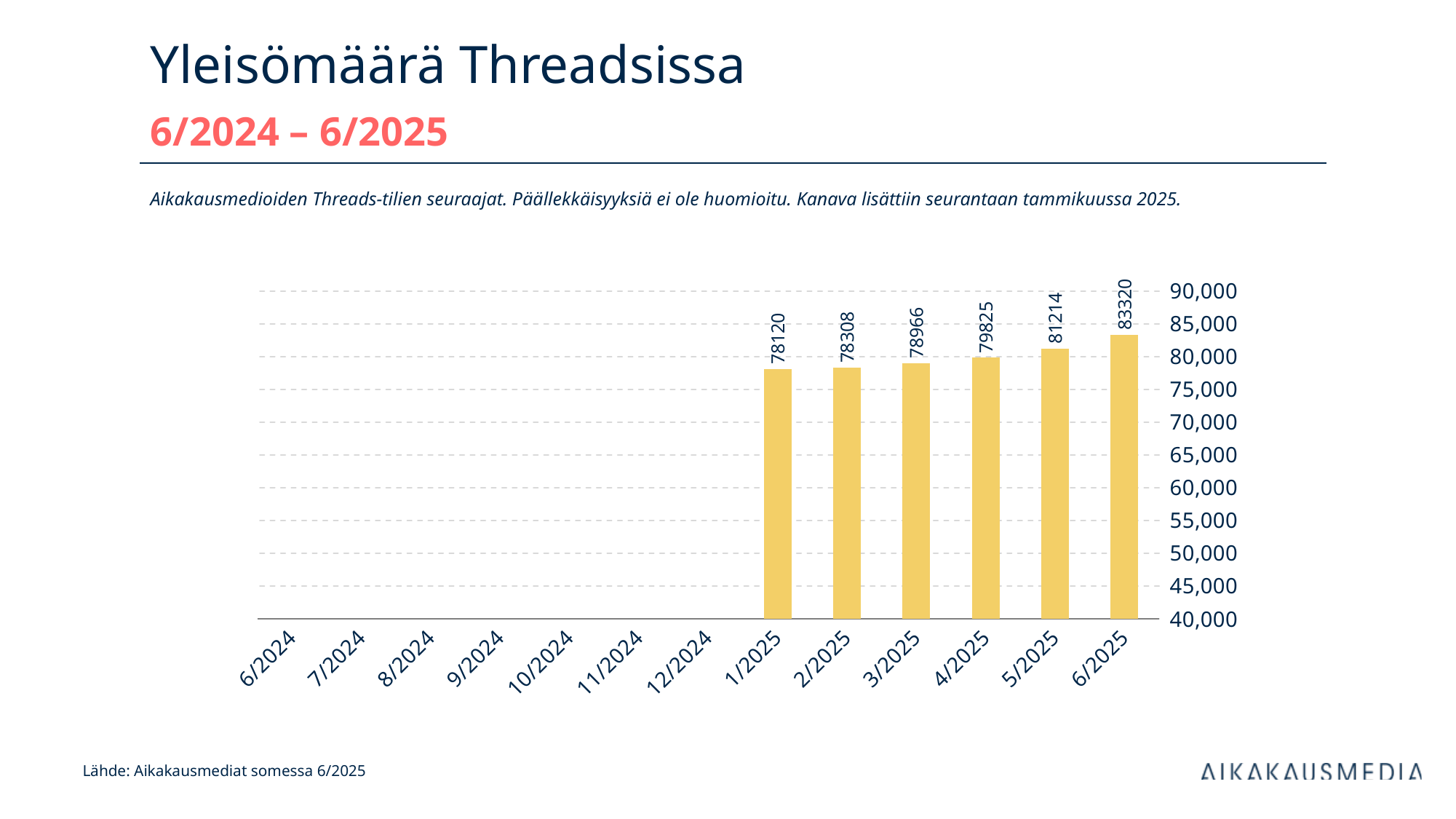
What kind of chart is shown on the slide? bar chart Which month has the highest value? 6/2025 What is the value for 6/2025? 83320 Do the values rise or fall from 1/2025 to 6/2025? rise Is the value for 5/2025 greater or less than 80,000? greater What is the value for 1/2025? 78120 Which month with a plotted bar has the lowest value? 1/2025 What is the difference between the values for 5/2025 and 4/2025? 1389 Which is larger, the value for 3/2025 or the value for 2/2025? 3/2025 What is the difference between the values for 6/2025 and 1/2025? 5200 What is the value for 4/2025? 79825 How many months have a bar plotted in the chart? 6